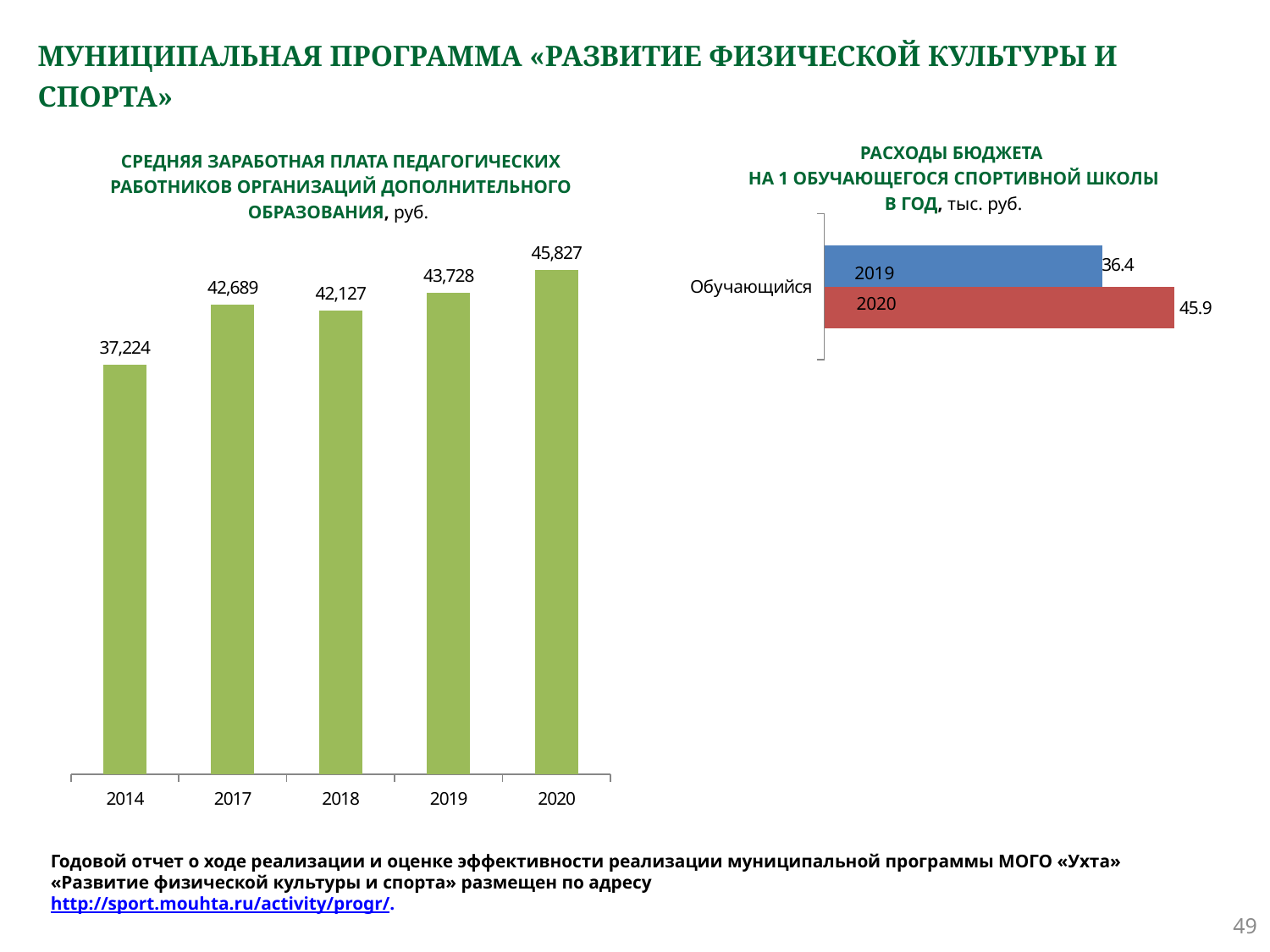
In the left chart (average salary of teaching staff), what is the value for 2018? 42,127 In the right chart (budget expenditure per student of the sports school), what is the value for 2019? 36.4 How many years are shown on the x axis of the left chart (average salary of teaching staff)? 5 What kind of chart is the left chart (average salary of teaching staff)? Bar chart In the left chart (average salary of teaching staff), which year has the highest value? 2020 In the left chart (average salary of teaching staff), what is the difference between the 2020 and 2019 values? 2,099 In the left chart (average salary of teaching staff), what is the value for 2014? 37,224 In the right chart (budget expenditure per student of the sports school), what is the value for 2020? 45.9 In the right chart (budget expenditure per student of the sports school), what is the difference between the 2020 and 2019 values? 9.5 In the left chart (average salary of teaching staff), which is larger: the value for 2017 or the value for 2018? 2017 In the right chart (budget expenditure per student of the sports school), what colour is the bar for 2020? Red In the left chart (average salary of teaching staff), which year has the lowest value? 2014